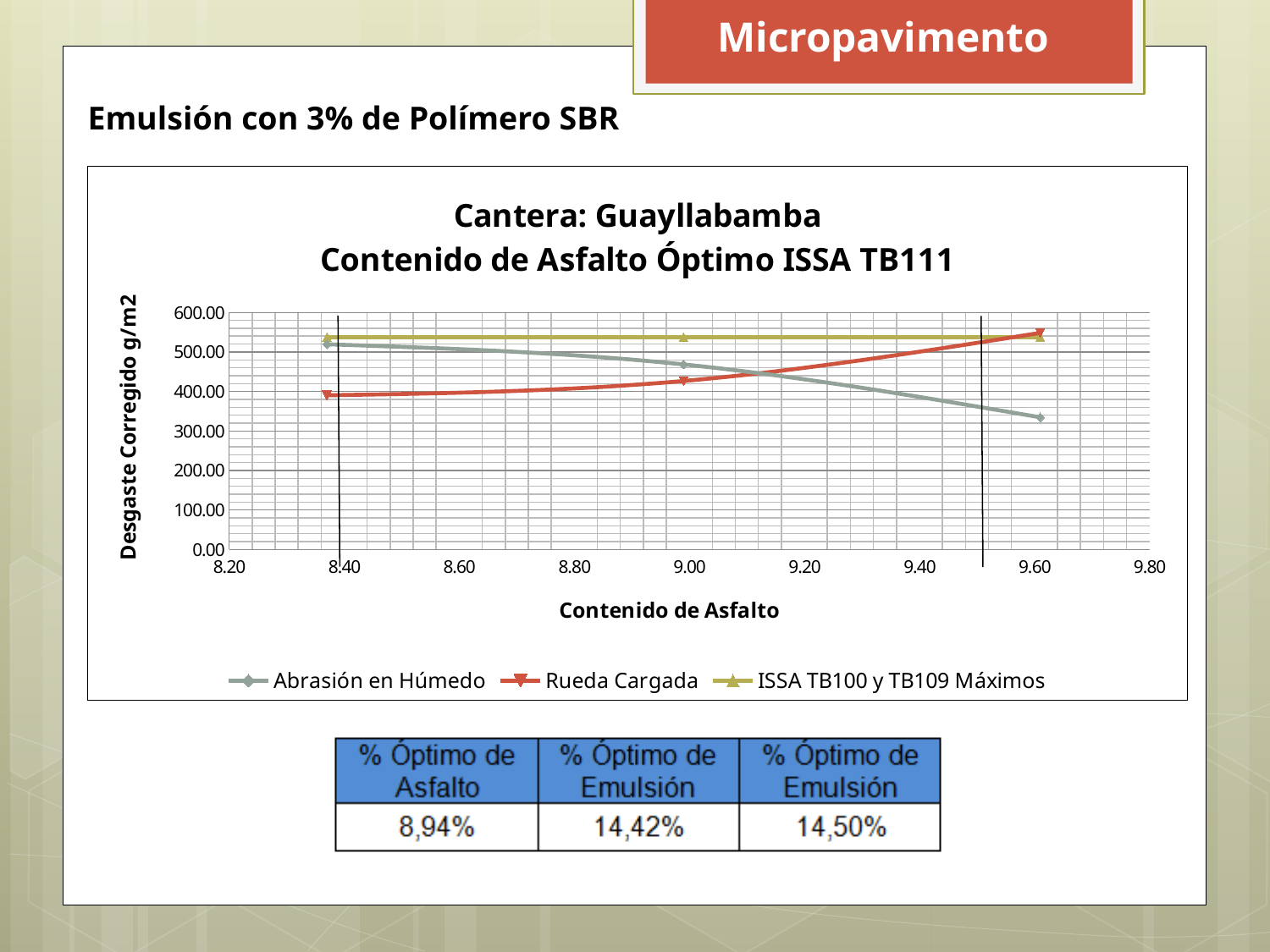
At the first data point (near 8.40), which series is higher: Abrasión en Húmedo or Rueda Cargada? Abrasión en Húmedo At the last data point (near 9.60), which series is higher: Abrasión en Húmedo or Rueda Cargada? Rueda Cargada How many data points are plotted for the Abrasión en Húmedo series? 3 What is the title of the chart? Cantera: Guayllabamba Contenido de Asfalto Óptimo ISSA TB111 Is the value of Rueda Cargada at its last point (near 9.60) greater or less than 500.00? greater Does the Rueda Cargada series rise or fall as Contenido de Asfalto increases? Rise Does the Abrasión en Húmedo series rise or fall as Contenido de Asfalto increases? Fall What is the label of the y axis? Desgaste Corregido g/m2 Is the value of Abrasión en Húmedo at its last point (near 9.60) greater or less than 400.00? less What kind of chart is shown on the slide? Line chart How many series does the legend list? 3 Is the ISSA TB100 y TB109 Máximos line greater or less than 500.00? greater